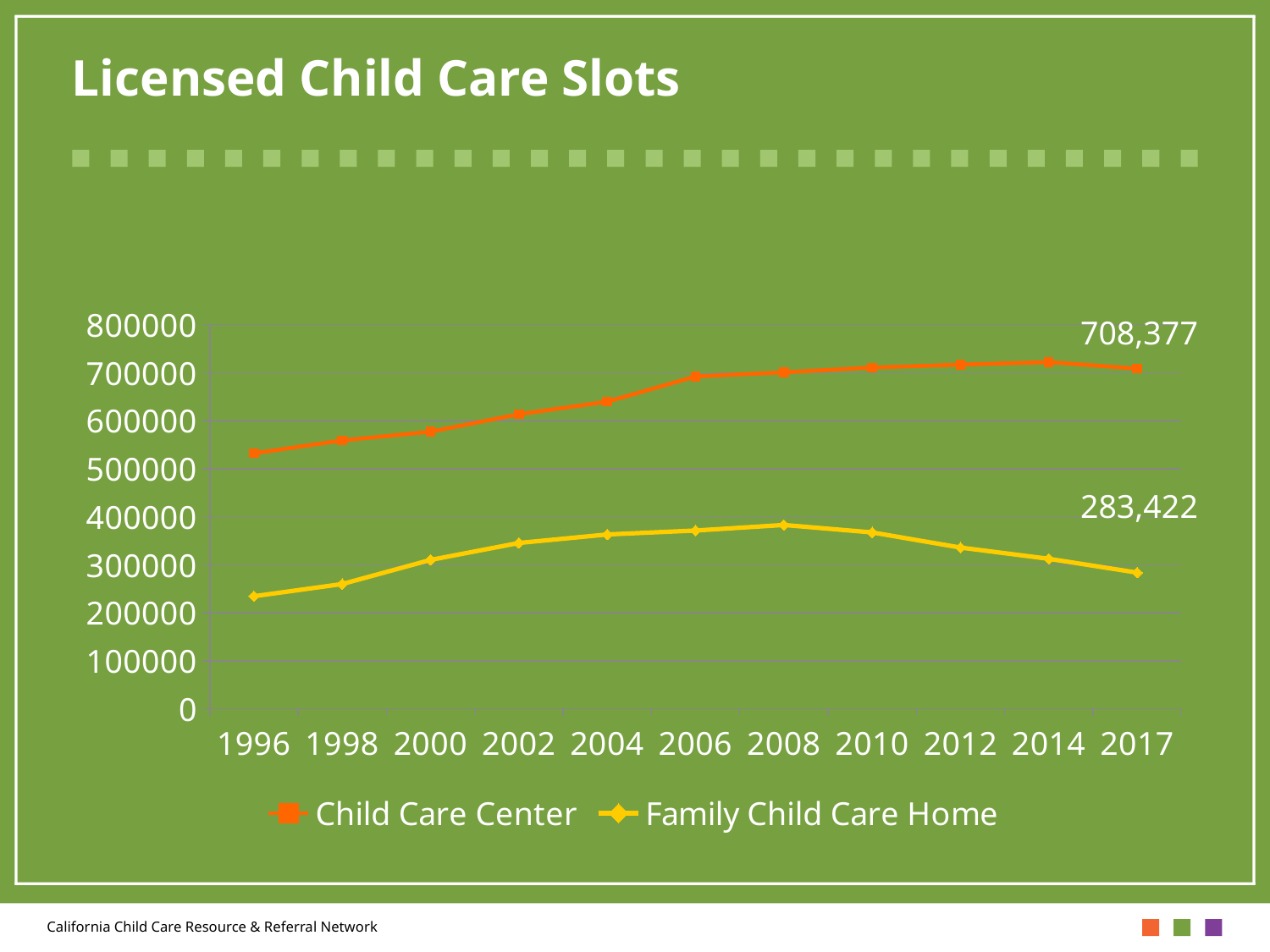
What is the value for Child Care Center in 2017? 708,377 What is the difference between the Child Care Center and Family Child Care Home values in 2017? 424,955 What is the value for Family Child Care Home in 2017? 283,422 In 2017, which series has the larger value, Child Care Center or Family Child Care Home? Child Care Center Is the value for Family Child Care Home in 1996 greater or less than 300000? less Is the value for Child Care Center in 1996 greater or less than 500000? greater How many years are shown on the x axis? 11 What kind of chart is shown on the slide? Line chart Is the value for Child Care Center in 2004 greater or less than 600000? greater In which year does the Family Child Care Home series reach its highest value? 2008 Does the Family Child Care Home series rise or fall from 2008 to 2017? fall How many series does the legend list? 2